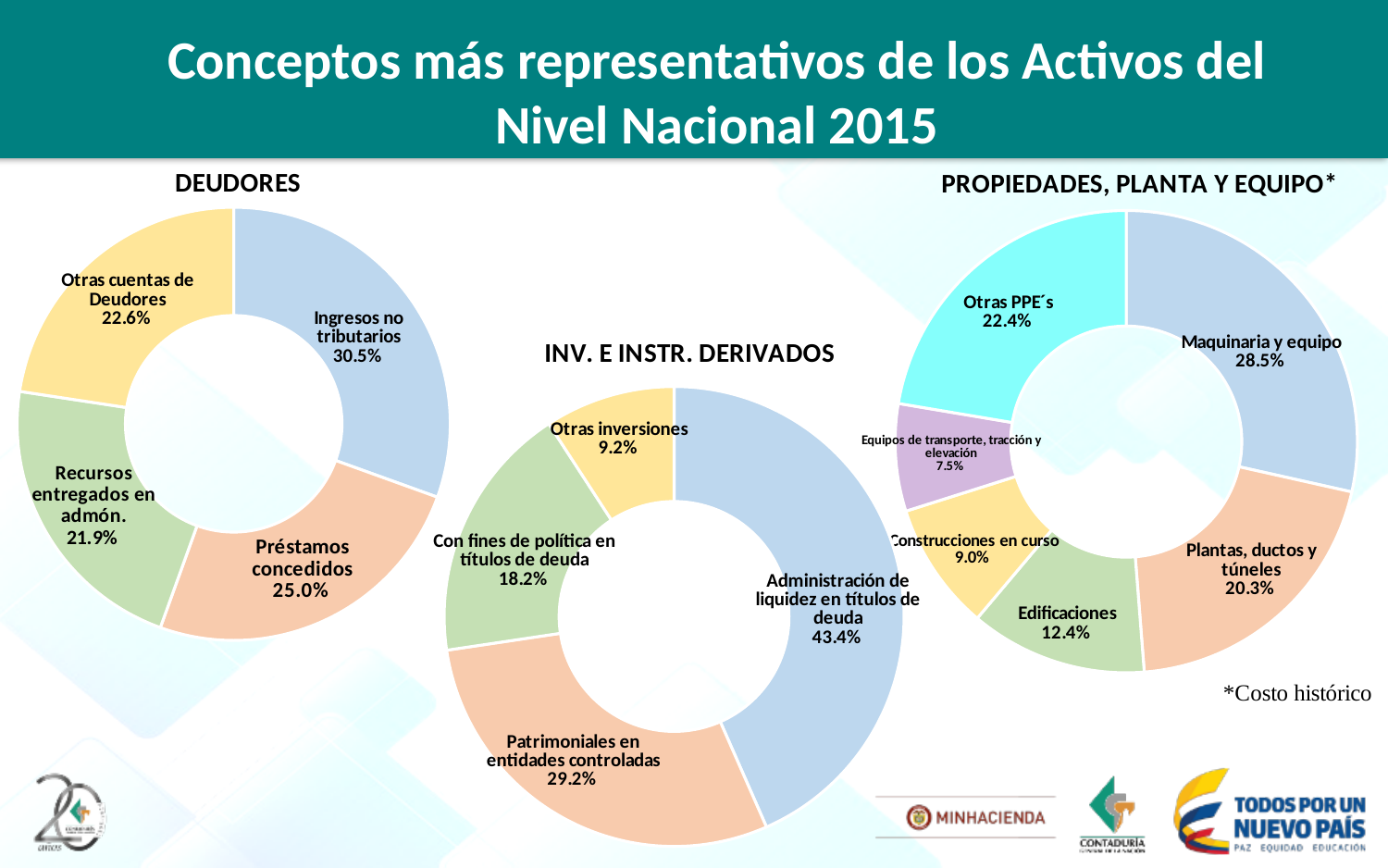
How many categories does the PROPIEDADES, PLANTA Y EQUIPO chart show? 6 In the DEUDORES chart, what share does Ingresos no tributarios represent? 30.5% What kind of chart is the INV. E INSTR. DERIVADOS chart? Doughnut (pie) chart In the INV. E INSTR. DERIVADOS chart, which category has the largest share? Administración de liquidez en títulos de deuda In the DEUDORES chart, which category has the smallest share? Recursos entregados en admón. How many categories does the DEUDORES chart show? 4 In the PROPIEDADES, PLANTA Y EQUIPO chart, which category has the smallest share? Equipos de transporte, tracción y elevación In the INV. E INSTR. DERIVADOS chart, what share does Patrimoniales en entidades controladas represent? 29.2% In the INV. E INSTR. DERIVADOS chart, which is larger: Con fines de política en títulos de deuda or Otras inversiones? Con fines de política en títulos de deuda In the DEUDORES chart, what is the difference between Ingresos no tributarios and Préstamos concedidos? 5.5% In the PROPIEDADES, PLANTA Y EQUIPO chart, what share does Edificaciones represent? 12.4% In the PROPIEDADES, PLANTA Y EQUIPO chart, what is the difference between Maquinaria y equipo and Plantas, ductos y túneles? 8.2%